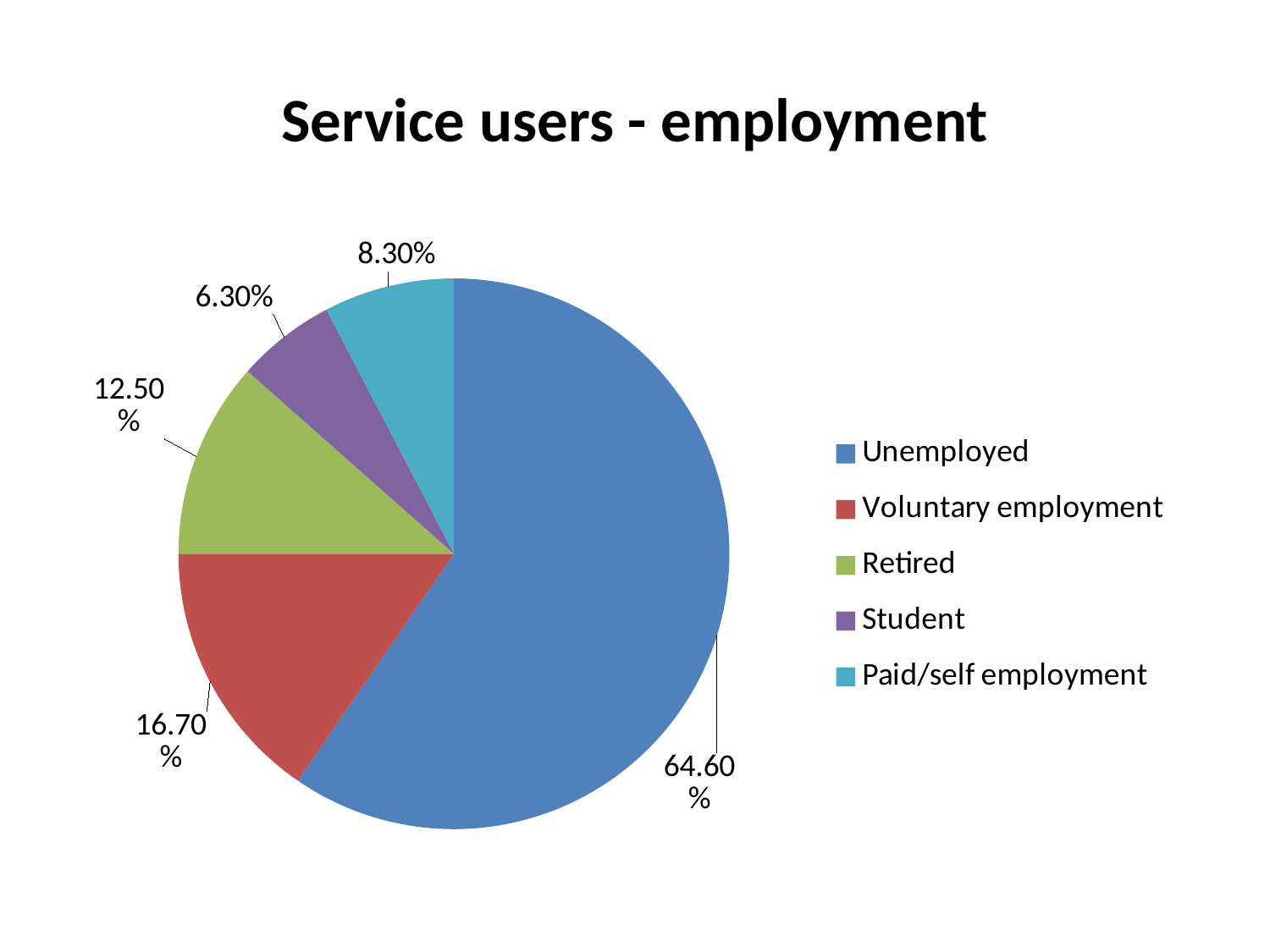
Which category has the smallest share of the pie? Student What percentage of service users are Retired? 12.50% What is the difference in percentage points between Voluntary employment and Retired? 4.20% What percentage of service users are Unemployed? 64.60% What is the title of the chart? Service users - employment Which category has the largest share of the pie? Unemployed Which is larger, the share for Retired or the share for Paid/self employment? Retired How many categories does the legend list? 5 What percentage of service users are Students? 6.30% What percentage of service users are in Voluntary employment? 16.70% What kind of chart is shown on the slide? pie chart What percentage of service users are in Paid/self employment? 8.30%